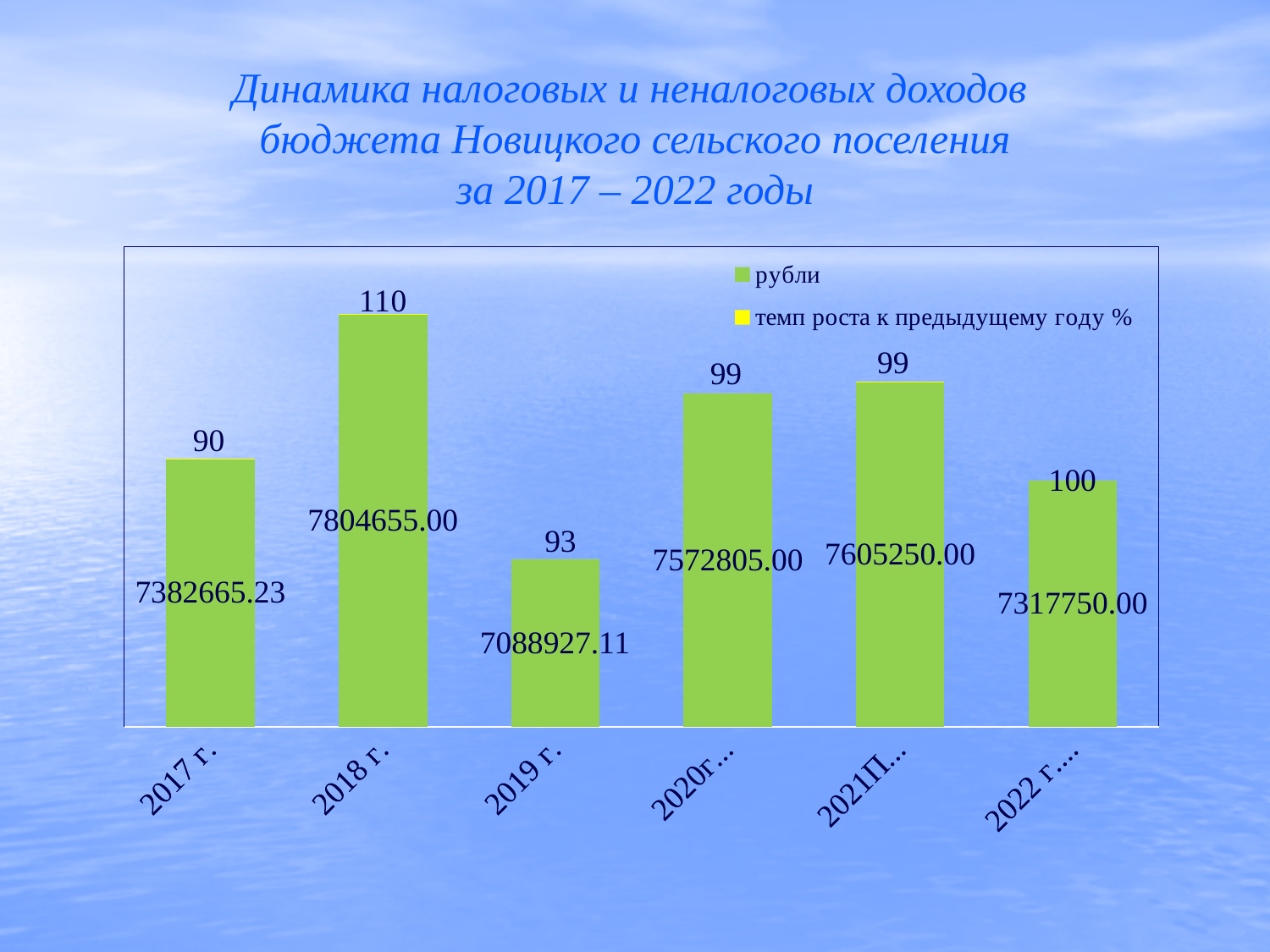
Which is larger, the value in rubles for 2020 or for 2021? 2021 Which year has the lowest value in rubles? 2019 г. What is the difference between the growth rate for 2018 г. and the growth rate for 2017 г.? 20 What is the value in rubles for 2019 г.? 7088927.11 Which year has the highest growth rate to the previous year? 2018 г. How many years (categories) are shown on the x axis? 6 What is the value in rubles for 2018 г.? 7804655.00 How many series does the legend list? 2 What is the value in rubles for 2017 г.? 7382665.23 What is the growth rate to the previous year (темп роста к предыдущему году %) for 2018 г.? 110 What is the growth rate to the previous year (темп роста к предыдущему году %) for 2019 г.? 93 What kind of chart is shown on the slide? Bar chart